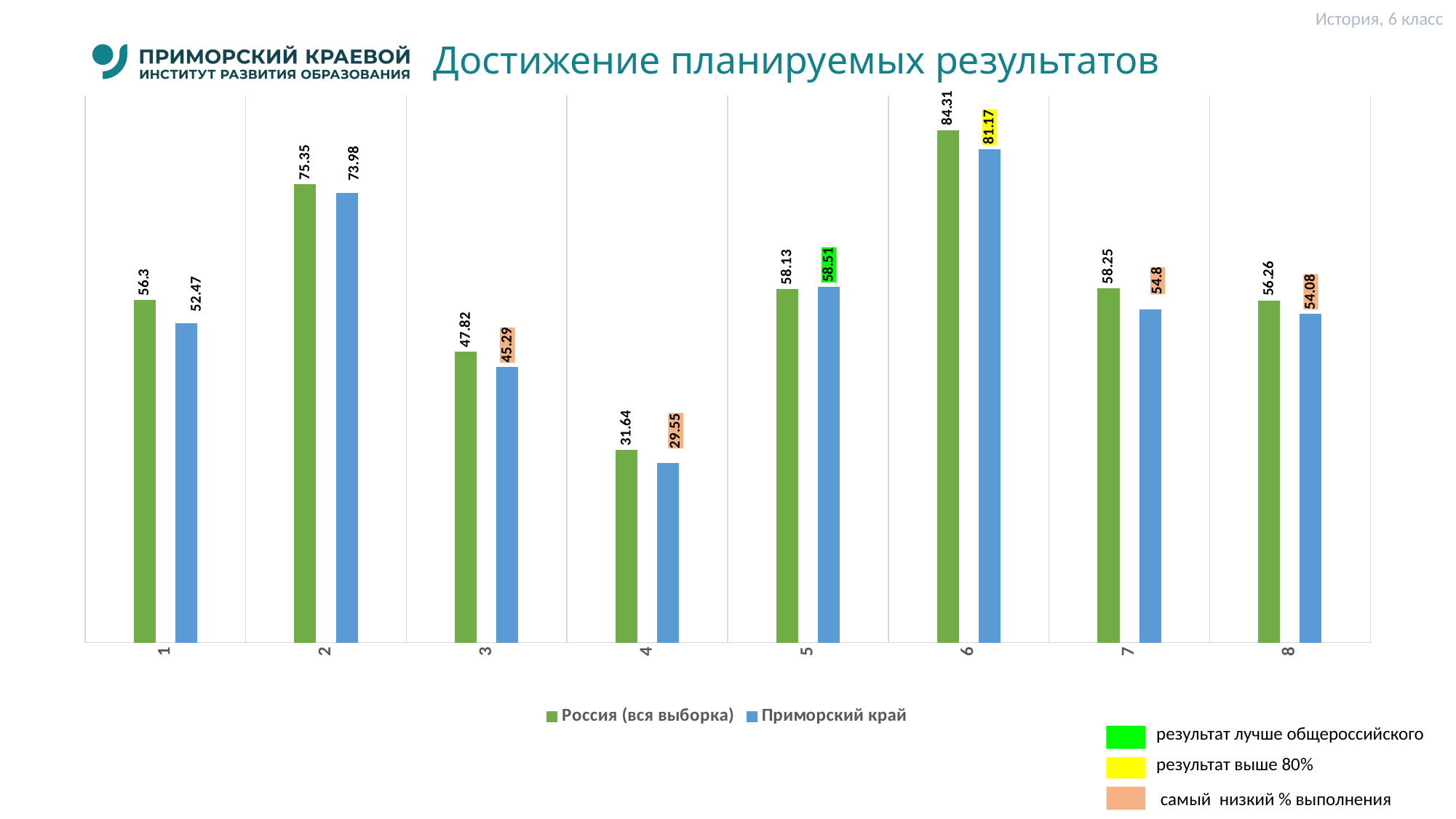
Which category has the highest value for Приморский край? 6 For category 5, which series has the larger value: Россия (вся выборка) or Приморский край? Приморский край Which colour in the legend marks a result above 80%? yellow What kind of chart is shown on the slide? bar chart What is the value for Приморский край for category 2? 73.98 How many categories are shown on the x axis? 8 What is the value for Россия (вся выборка) for category 6? 84.31 What is the difference between the Россия (вся выборка) and Приморский край values for category 7? 3.45 What is the value for Приморский край for category 4? 29.55 Which category has the lowest value for Россия (вся выборка)? 4 What is the title of the slide? Достижение планируемых результатов How many series does the chart legend list? 2